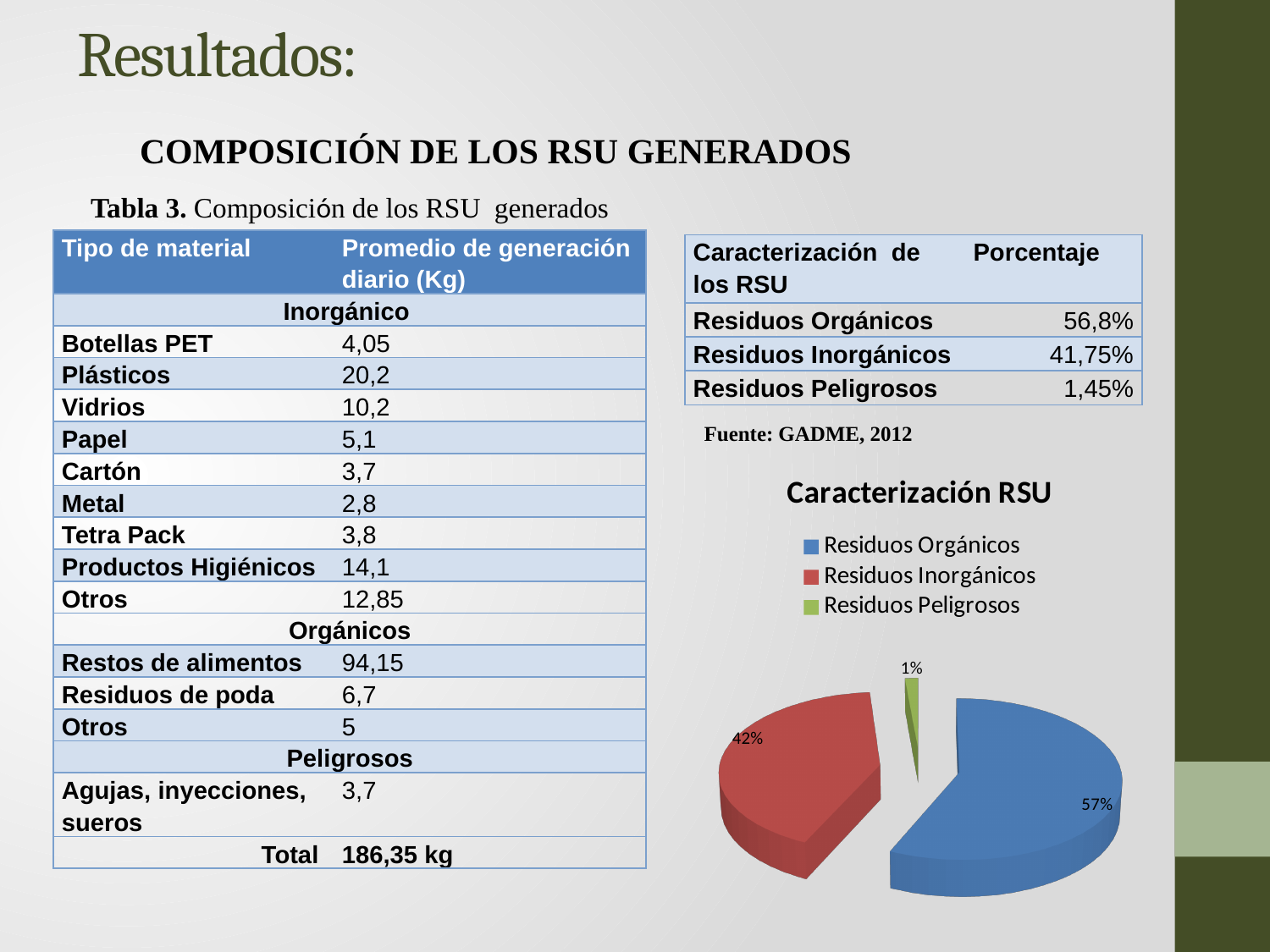
What percentage does the pie chart show for Residuos Orgánicos? 57% Which category has the largest slice in the pie chart? Residuos Orgánicos Which is larger in the pie chart, Residuos Orgánicos or Residuos Inorgánicos? Residuos Orgánicos How many slices does the pie chart have? 3 What is the difference in percentage points between the Residuos Orgánicos and Residuos Inorgánicos slices? 15 Which colour represents Residuos Peligrosos in the pie chart? green What percentage does the pie chart show for Residuos Inorgánicos? 42% How many entries does the chart legend list? 3 What percentage does the pie chart show for Residuos Peligrosos? 1% Which category has the smallest slice in the pie chart? Residuos Peligrosos What is the title of the chart? Caracterización RSU What kind of chart is shown on the slide? pie chart